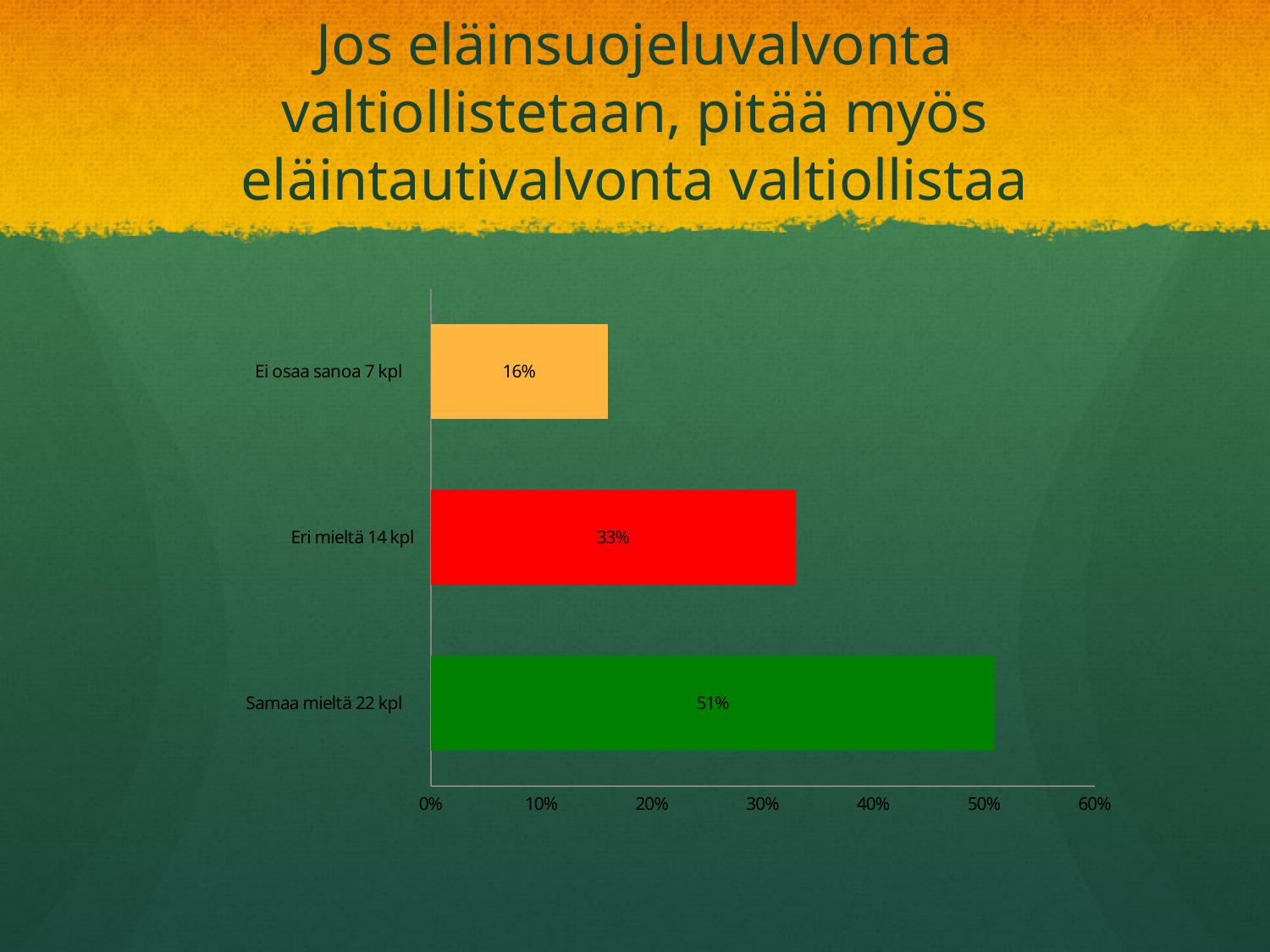
What is the difference between the values for "Samaa mieltä 22 kpl" and "Eri mieltä 14 kpl"? 18% How many categories are shown in the chart? 3 Which category has the lowest value? Ei osaa sanoa 7 kpl What is the value for "Ei osaa sanoa 7 kpl"? 16% What is the value for "Samaa mieltä 22 kpl"? 51% What is the value for "Eri mieltä 14 kpl"? 33% Which category has the highest value? Samaa mieltä 22 kpl Which is larger, the value for "Eri mieltä 14 kpl" or "Ei osaa sanoa 7 kpl"? Eri mieltä 14 kpl Is the value for "Samaa mieltä 22 kpl" greater or less than 40%? greater What colour is the bar for "Eri mieltä 14 kpl"? Red What is the difference between the values for "Eri mieltä 14 kpl" and "Ei osaa sanoa 7 kpl"? 17% What kind of chart is shown on the slide? Bar chart